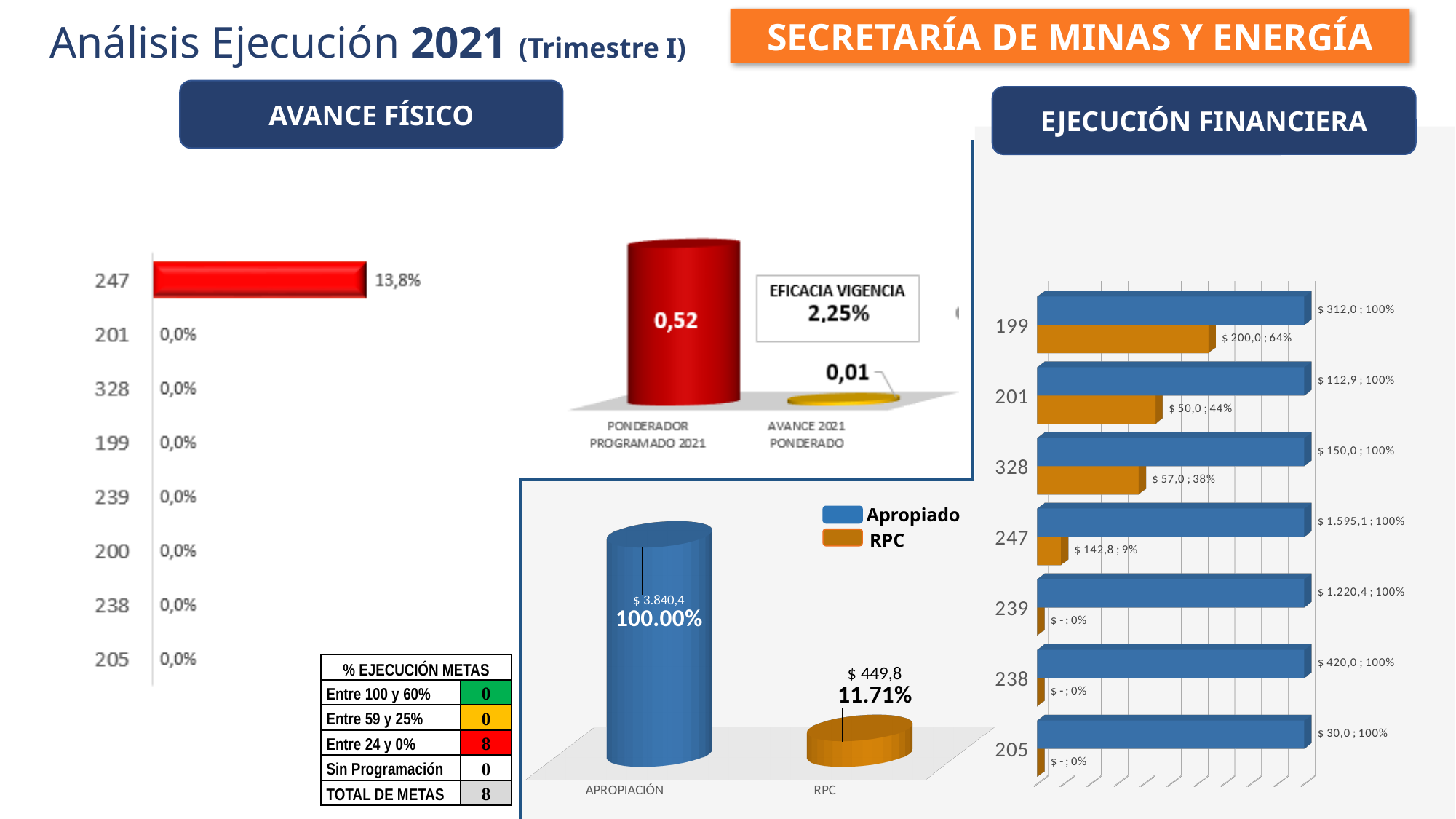
In the Ejecución Financiera bar chart on the right, what RPC percentage is shown for category 199? 64% In the Ejecución Financiera bar chart on the right, which category has the highest Apropiado value? 247 In the cylinder chart with Ponderador Programado 2021 and Avance 2021 Ponderado, what is the value for Avance 2021 Ponderado? 0,01 In the Avance Físico bar chart on the left, how many categories are shown? 8 In the Apropiación vs RPC cylinder chart at the bottom centre, what is the value labelled for RPC? $ 449,8 In the Ejecución Financiera bar chart on the right, what is the Apropiado value for category 247? $ 1.595,1 In the cylinder chart with Ponderador Programado 2021 and Avance 2021 Ponderado, what is the value for Ponderador Programado 2021? 0,52 In the Apropiación vs RPC cylinder chart at the bottom centre, what percentage is shown for Apropiación? 100.00% In the Ejecución Financiera bar chart on the right, how many series does the legend list? 2 In the Avance Físico bar chart on the left, what is the value for category 247? 13,8% In the Avance Físico bar chart on the left, which category has the highest value? 247 In the Ejecución Financiera bar chart on the right, what is the difference between the Apropiado and RPC values for category 201? $ 62,9